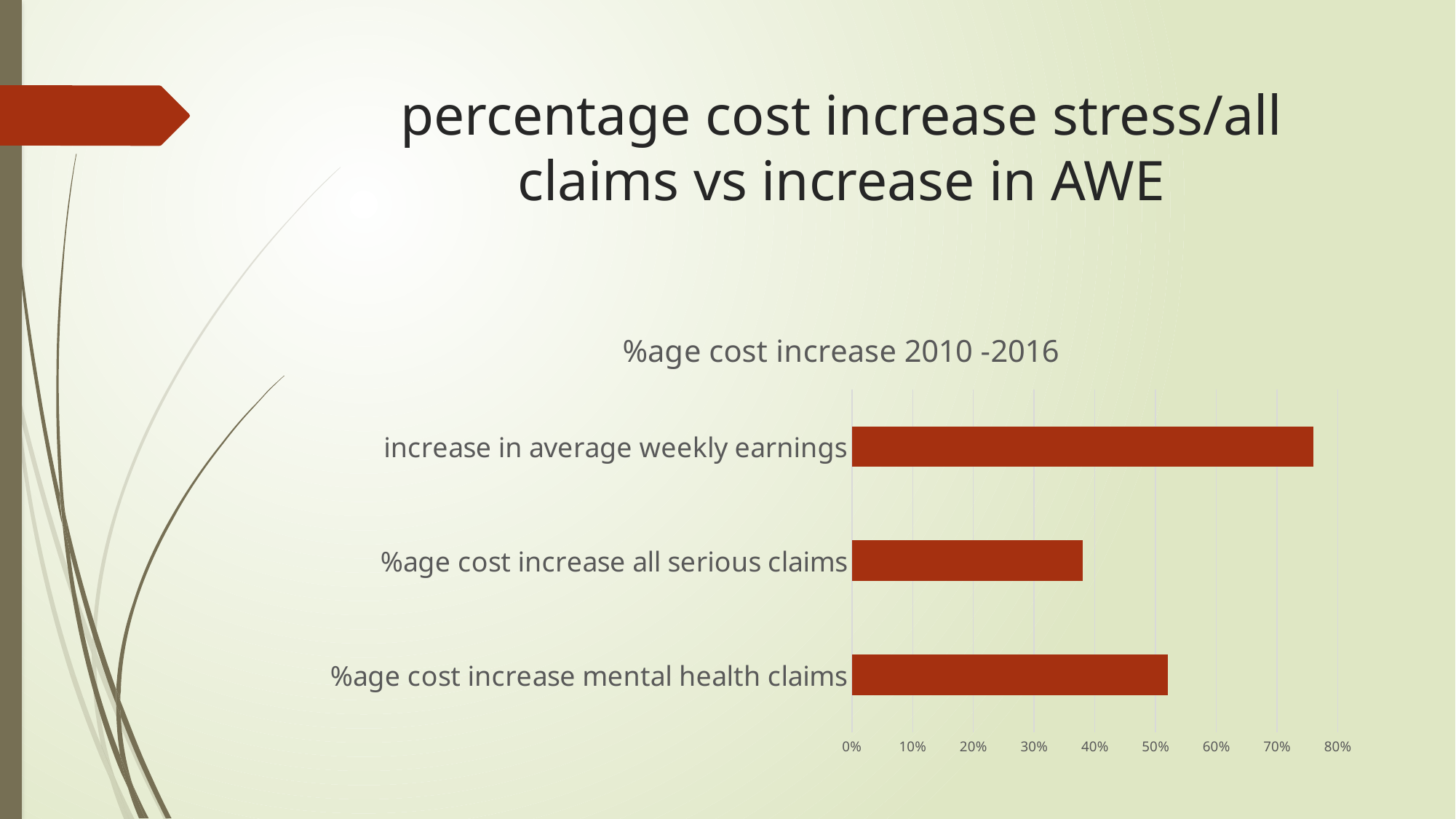
Is the value for %age cost increase all serious claims greater or less than 30%? greater Which is larger: the value for increase in average weekly earnings or the value for %age cost increase mental health claims? increase in average weekly earnings What is the title of the chart? %age cost increase 2010 -2016 Is the value for increase in average weekly earnings greater or less than 70%? greater Which category has the lowest value? %age cost increase all serious claims What colour are the bars in the chart? red Is the value for %age cost increase mental health claims greater or less than 60%? less How many categories are plotted in the chart? 3 What kind of chart is shown on the slide? bar chart Which is larger: the value for %age cost increase mental health claims or the value for %age cost increase all serious claims? %age cost increase mental health claims Which category has the highest value? increase in average weekly earnings